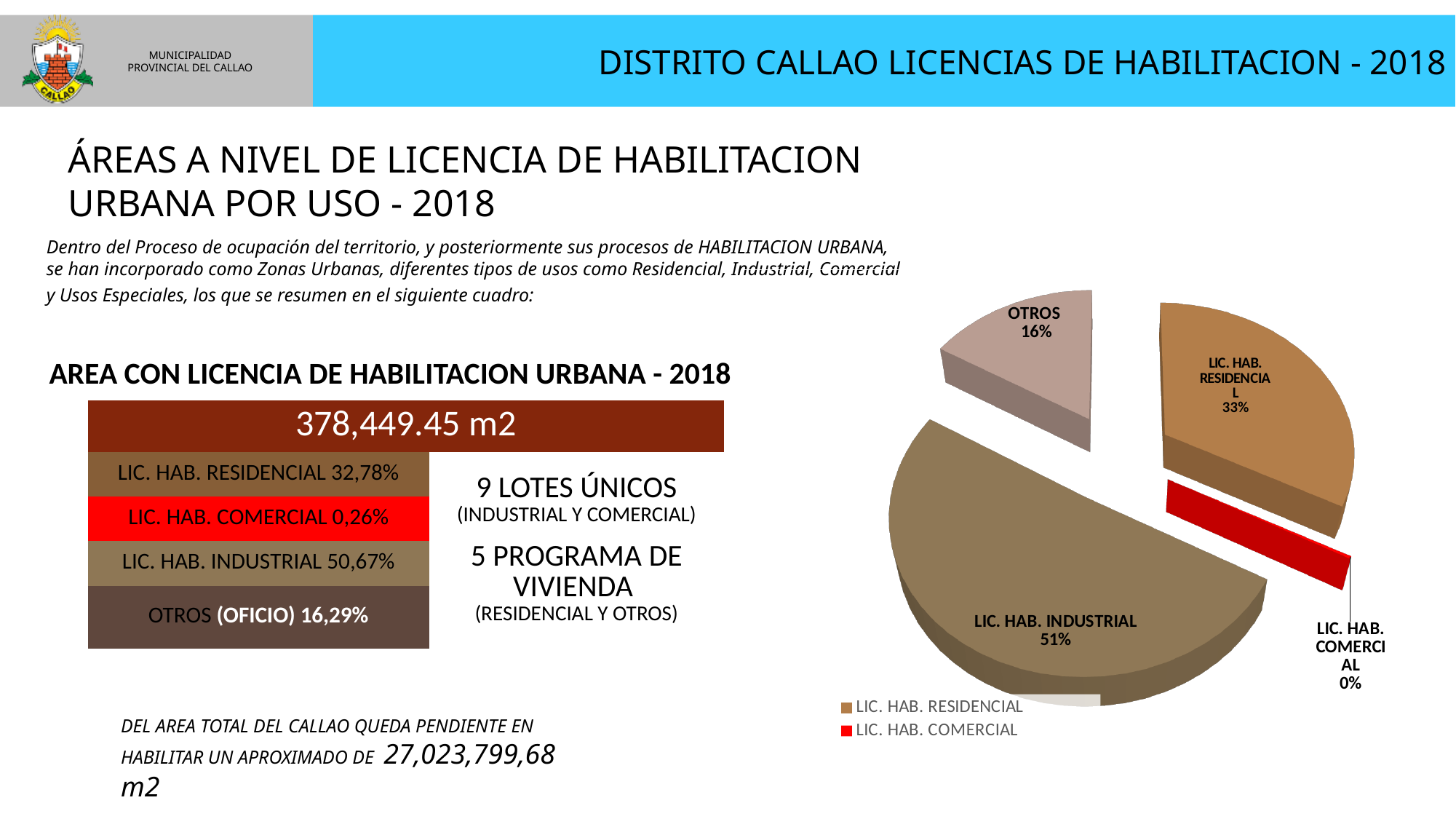
Which is larger in the pie chart, OTROS or LIC. HAB. RESIDENCIAL? LIC. HAB. RESIDENCIAL What is the difference in percentage points between the LIC. HAB. INDUSTRIAL slice and the LIC. HAB. RESIDENCIAL slice? 18 In the pie chart, what share does OTROS have? 16% Which slice of the pie chart is the largest? LIC. HAB. INDUSTRIAL How many slices does the pie chart have? 4 In the pie chart, what share does LIC. HAB. COMERCIAL have? 0% Which slice of the pie chart is the smallest? LIC. HAB. COMERCIAL In the pie chart, what share does LIC. HAB. INDUSTRIAL have? 51% What colour is the LIC. HAB. COMERCIAL slice in the pie chart? red What is the difference in percentage points between the LIC. HAB. RESIDENCIAL slice and the OTROS slice? 17 What kind of chart is shown on the right side of the slide? pie chart